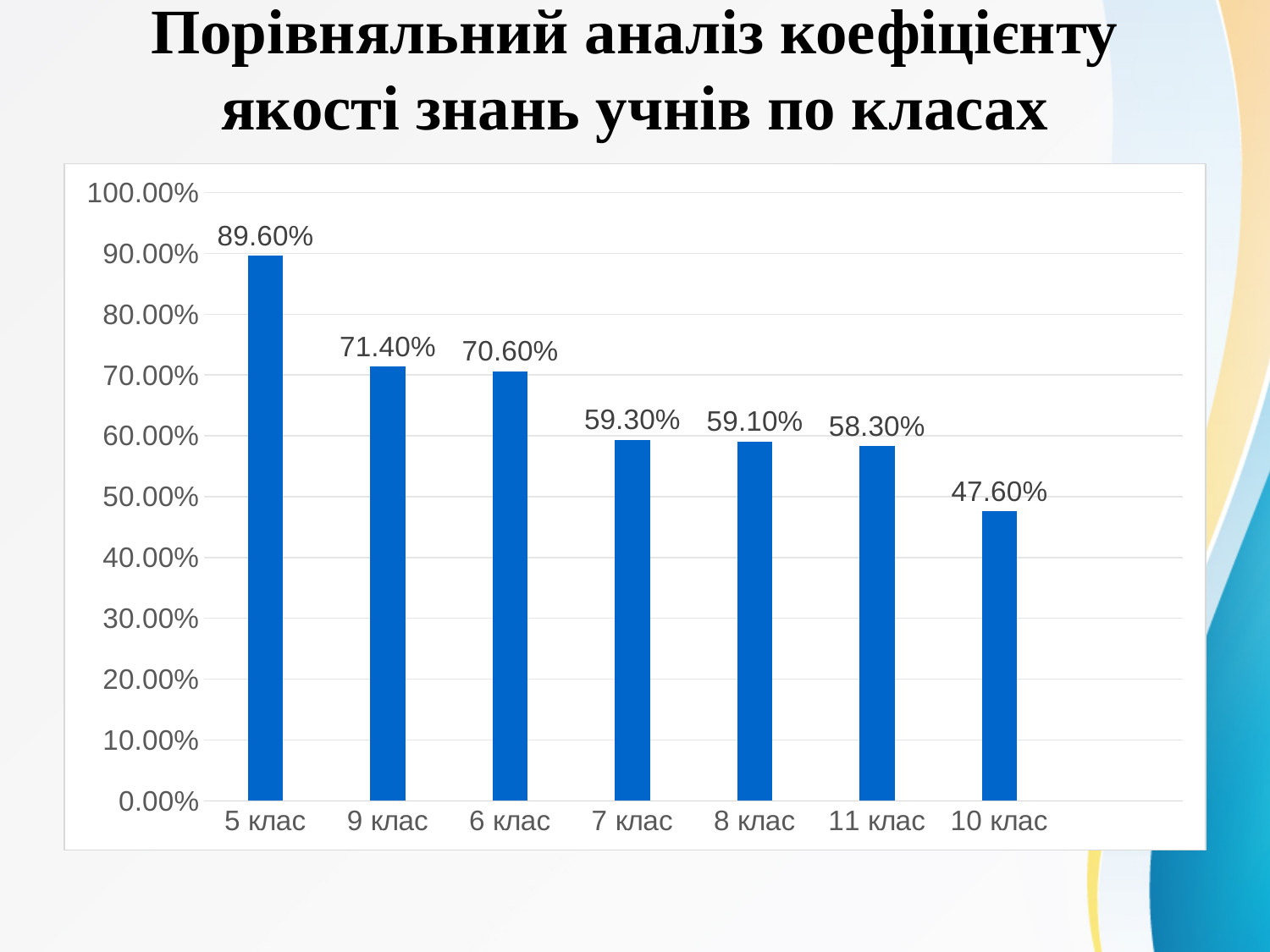
Which class has the lowest value? 10 клас How many classes are shown on the x axis? 7 Is the value for 8 клас greater or less than 50.00%? greater Which class has the highest value? 5 клас What is the difference between the values for 9 клас and 6 клас? 0.80% What is the value for 10 клас? 47.60% What is the value for 7 клас? 59.30% What is the difference between the values for 5 клас and 10 клас? 42.00% Do the values rise or fall from left to right along the x axis? fall What is the value for 5 клас? 89.60% Which is larger, the value for 9 клас or the value for 11 клас? 9 клас What kind of chart is shown on the slide? bar chart